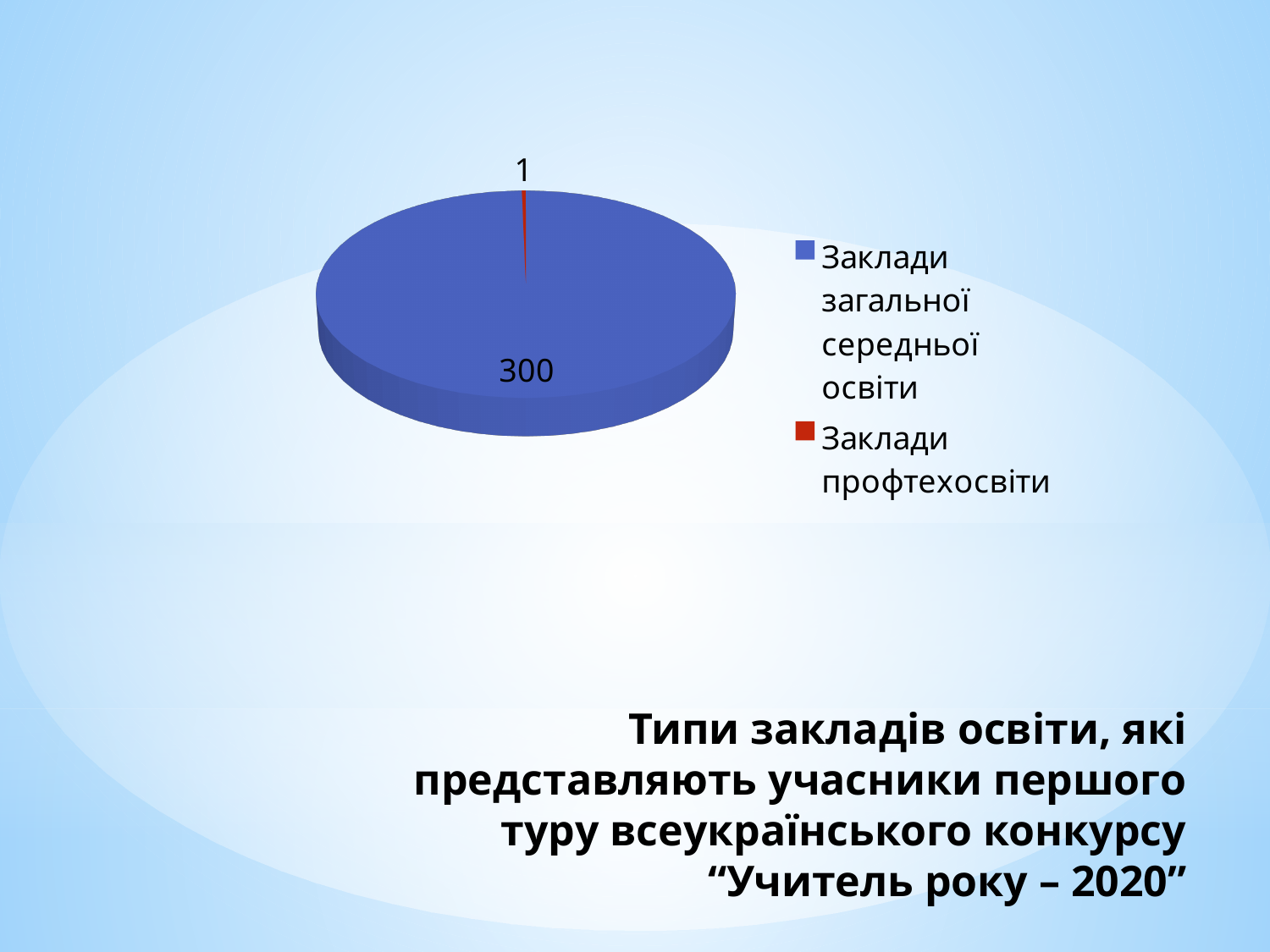
How many entries does the legend list? 2 What is the total of all slices in the pie chart? 301 What is the difference between the values for Заклади загальної середньої освіти and Заклади профтехосвіти? 299 Which is larger: the value for Заклади загальної середньої освіти or for Заклади профтехосвіти? Заклади загальної середньої освіти What is the title text shown on the slide for this chart? Типи закладів освіти, які представляють учасники першого туру всеукраїнського конкурсу “Учитель року – 2020” What is the value for Заклади профтехосвіти? 1 How many categories does the pie chart have? 2 What colour is the slice for Заклади профтехосвіти? Red What is the value for Заклади загальної середньої освіти? 300 Which category has the largest slice of the pie? Заклади загальної середньої освіти Which category has the smallest slice of the pie? Заклади профтехосвіти What type of chart is shown on the slide? Pie chart